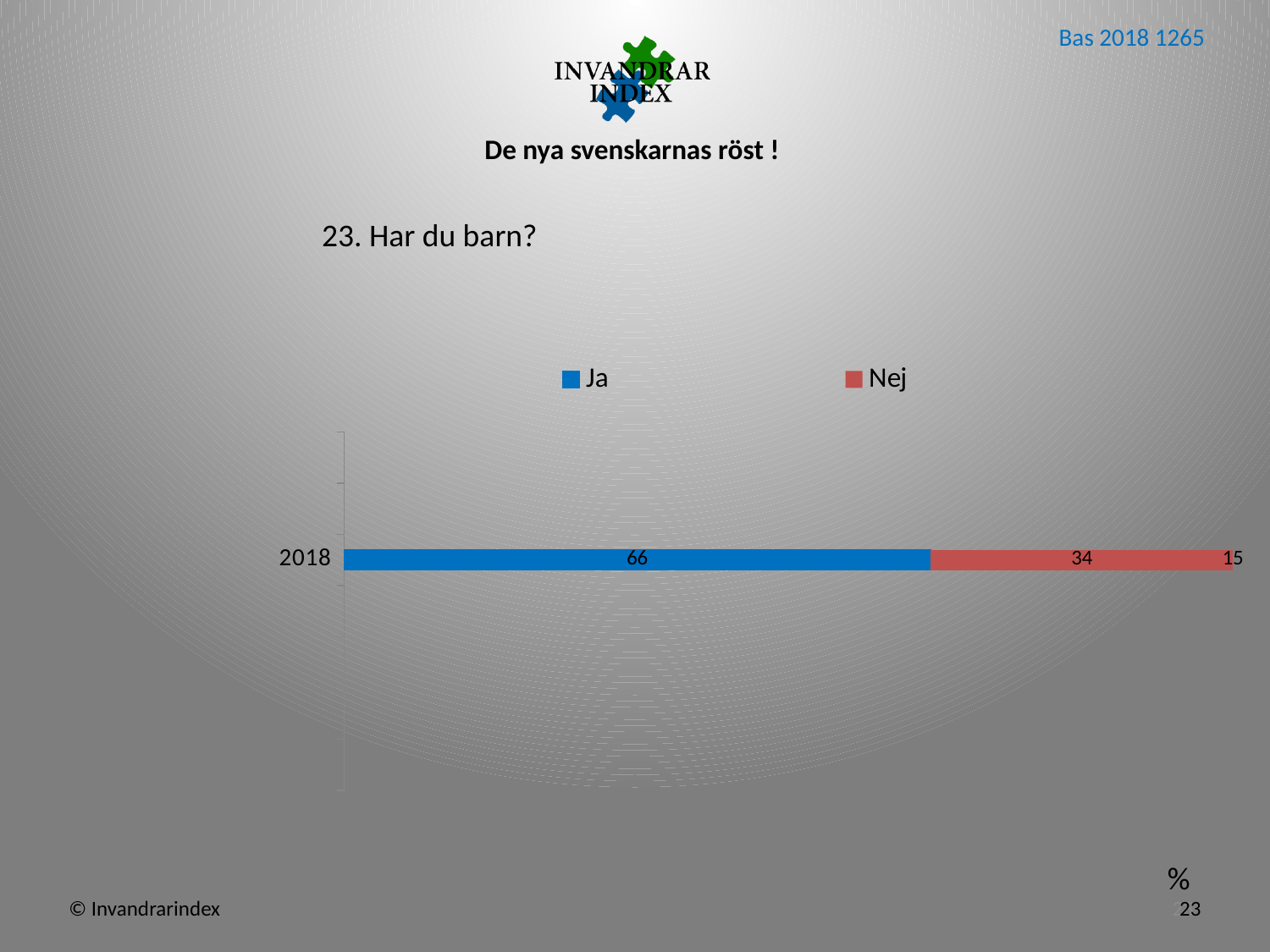
What colour represents the Ja series in the chart? Blue What is the difference between the Ja and Nej values in 2018? 32 How many series does the legend list? 2 What is the value for Ja in 2018? 66 Which series has the larger value in 2018, Ja or Nej? Ja Which year is shown as the category on the chart? 2018 How many categories are shown on the vertical axis of the chart? 1 What kind of chart is shown on the slide? Stacked bar chart What is the value for Nej in 2018? 34